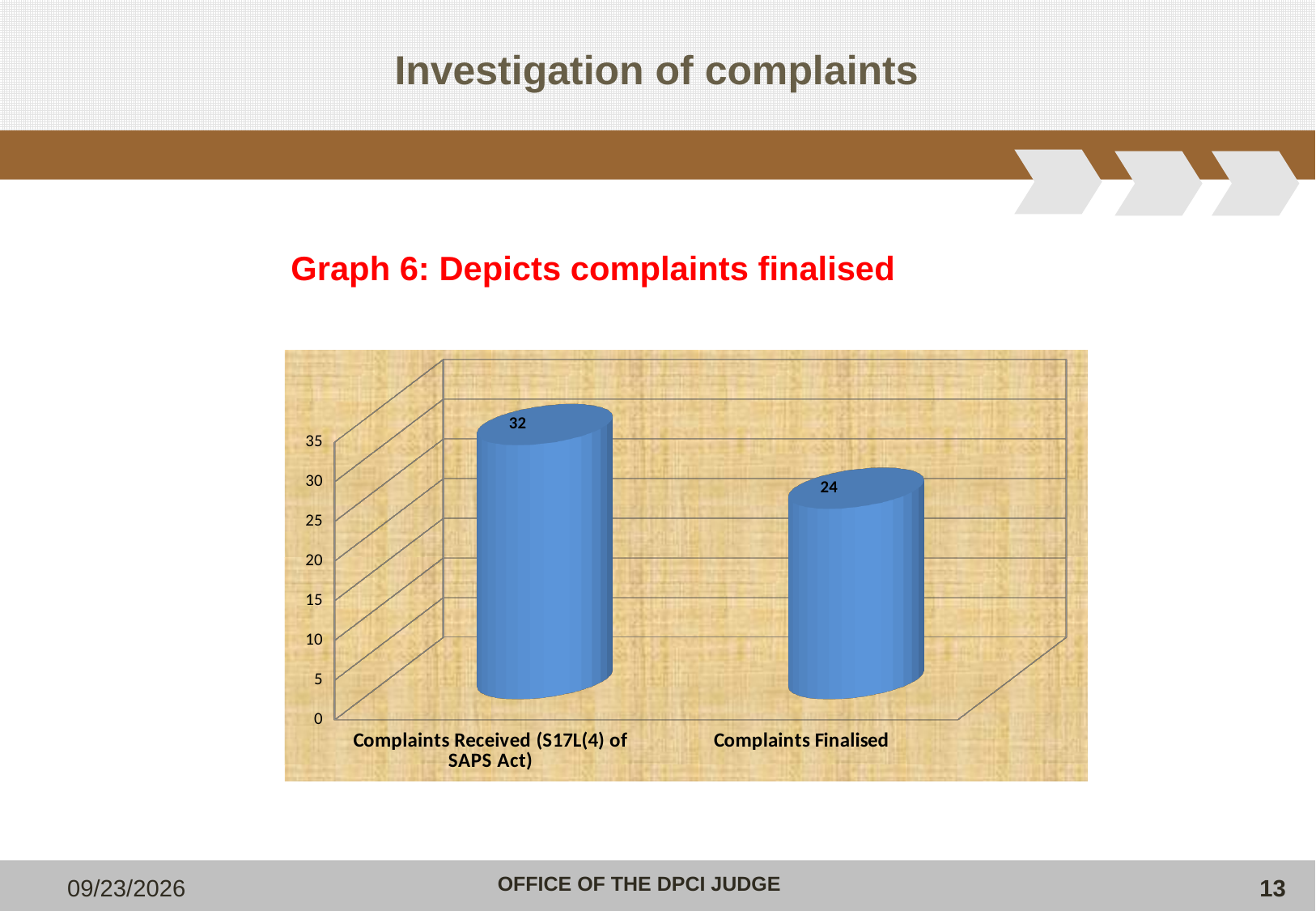
Is the value for Complaints Finalised greater or less than 30? less How many categories are shown in the chart? 2 Which category has the highest value? Complaints Received (S17L(4) of SAPS Act) What is the difference between Complaints Received and Complaints Finalised? 8 Which category has the lowest value? Complaints Finalised What is the value for Complaints Finalised? 24 What is the value for Complaints Received (S17L(4) of SAPS Act)? 32 Which is larger, Complaints Received or Complaints Finalised? Complaints Received What kind of chart is shown on the slide? bar chart Is the value for Complaints Received greater or less than 30? greater What is the title of the graph shown on the slide? Graph 6: Depicts complaints finalised What is the highest value shown on the vertical axis? 35